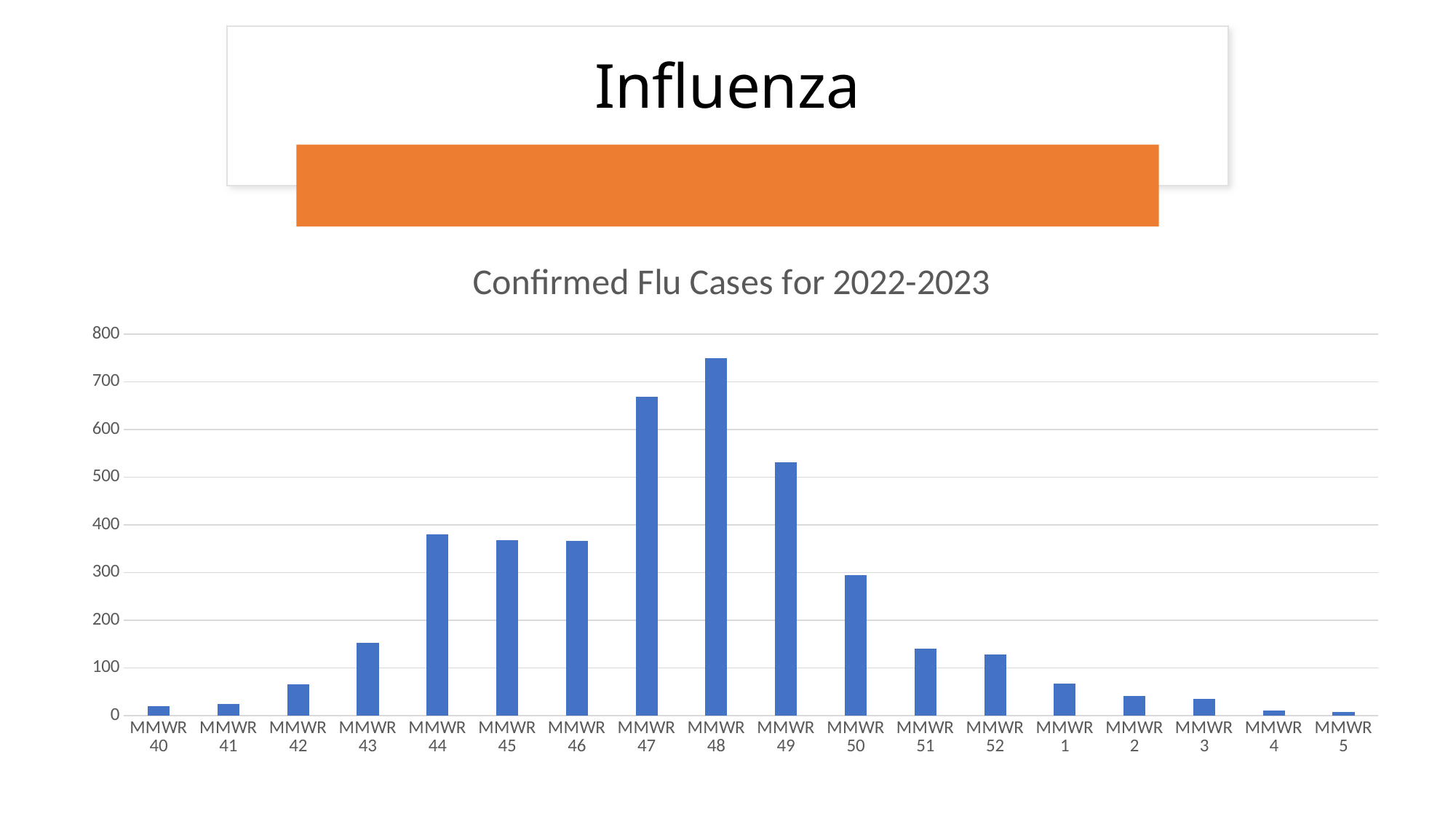
Is the value for MMWR 43 greater or less than 100? greater Is the value for MMWR 42 greater or less than 100? less Do the values rise or fall from MMWR 48 to MMWR 5? fall Which has more confirmed flu cases, MMWR 43 or MMWR 44? MMWR 44 Which MMWR week has the highest number of confirmed flu cases? MMWR 48 Is the value for MMWR 48 greater or less than 700? greater Which has more confirmed flu cases, MMWR 47 or MMWR 49? MMWR 47 What kind of chart is shown on the slide? Bar chart How many MMWR weeks are plotted on the x axis? 18 What is the title of the chart? Confirmed Flu Cases for 2022-2023